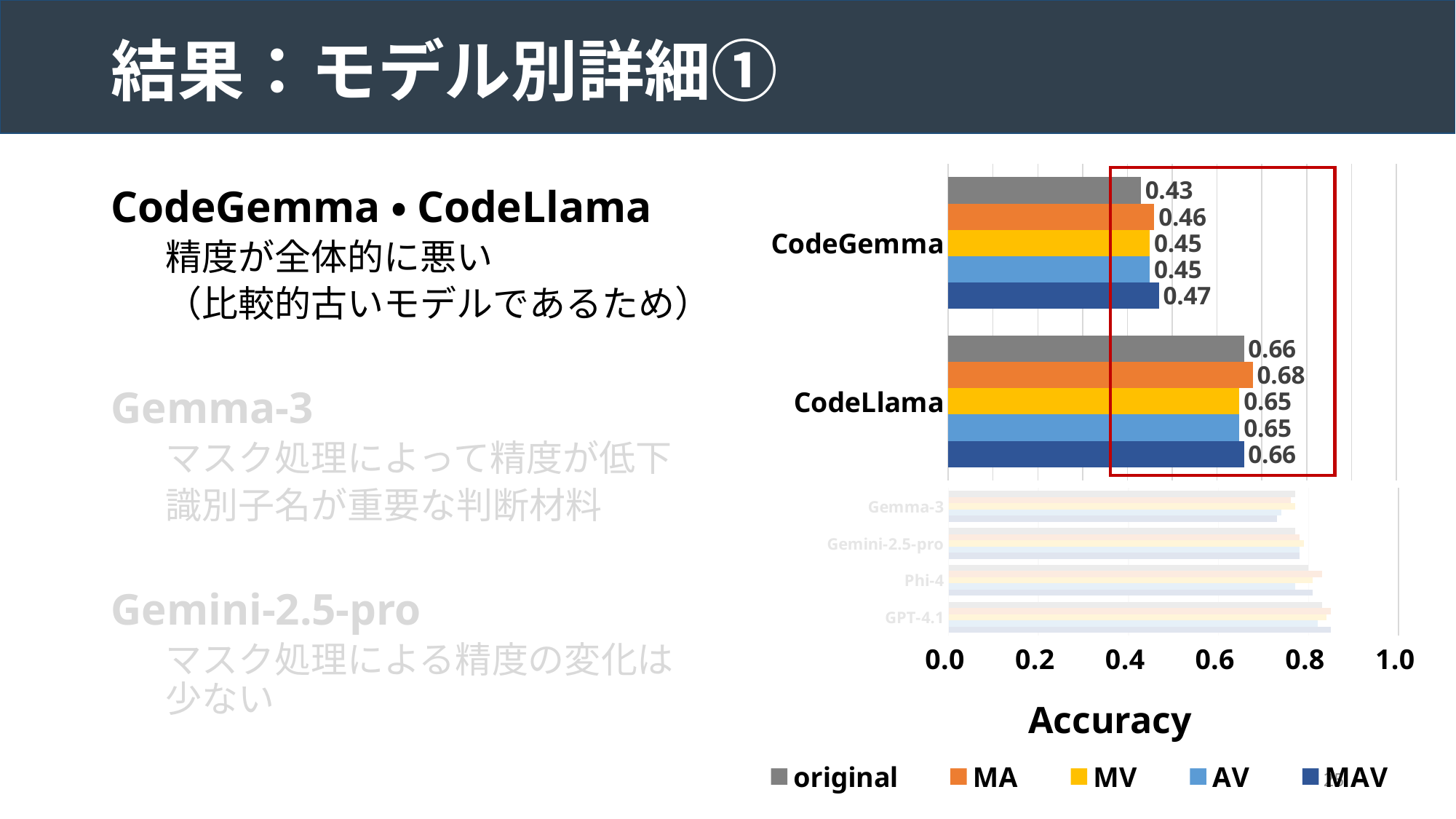
How many series does the legend list? 5 What is the MAV accuracy for CodeGemma? 0.47 Which is larger, the original accuracy for CodeLlama or the MAV accuracy for CodeGemma? original accuracy for CodeLlama Which series has the highest accuracy for CodeGemma? MAV What is the original accuracy for CodeGemma? 0.43 Which series has the highest accuracy for CodeLlama? MA What is the title of the horizontal axis? Accuracy What is the AV accuracy for CodeLlama? 0.65 Is the MV accuracy for CodeLlama greater or less than 0.6? greater What is the difference between the MA accuracy of CodeLlama and the MA accuracy of CodeGemma? 0.22 Which series has the lowest accuracy for CodeGemma? original What is the MA accuracy for CodeLlama? 0.68